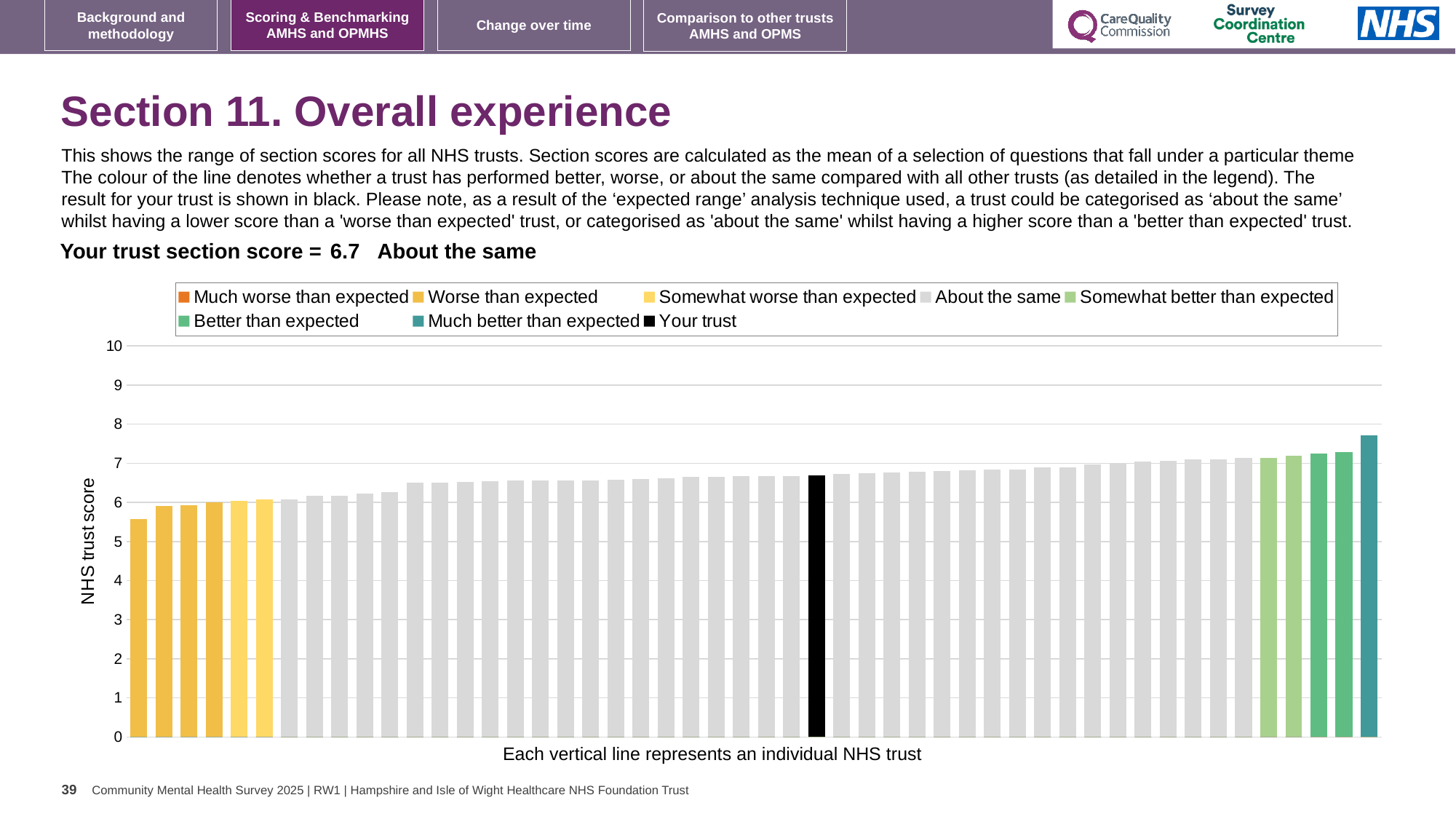
Is the value of the highest bar in the chart greater or less than 8? less Which category is your trust placed in for this section? About the same What is the section score for your trust? 6.7 Is the value of the highest bar in the chart greater or less than 7? greater What kind of chart is shown on the slide? bar chart Is the value of the black 'Your trust' bar greater or less than 6? greater What is the label on the y axis of the chart? NHS trust score How many bars are coloured as 'Much better than expected' (teal)? 1 What colour is the bar representing your trust? black Do the bar values rise or fall from left to right along the x axis? rise How many entries does the chart legend list? 8